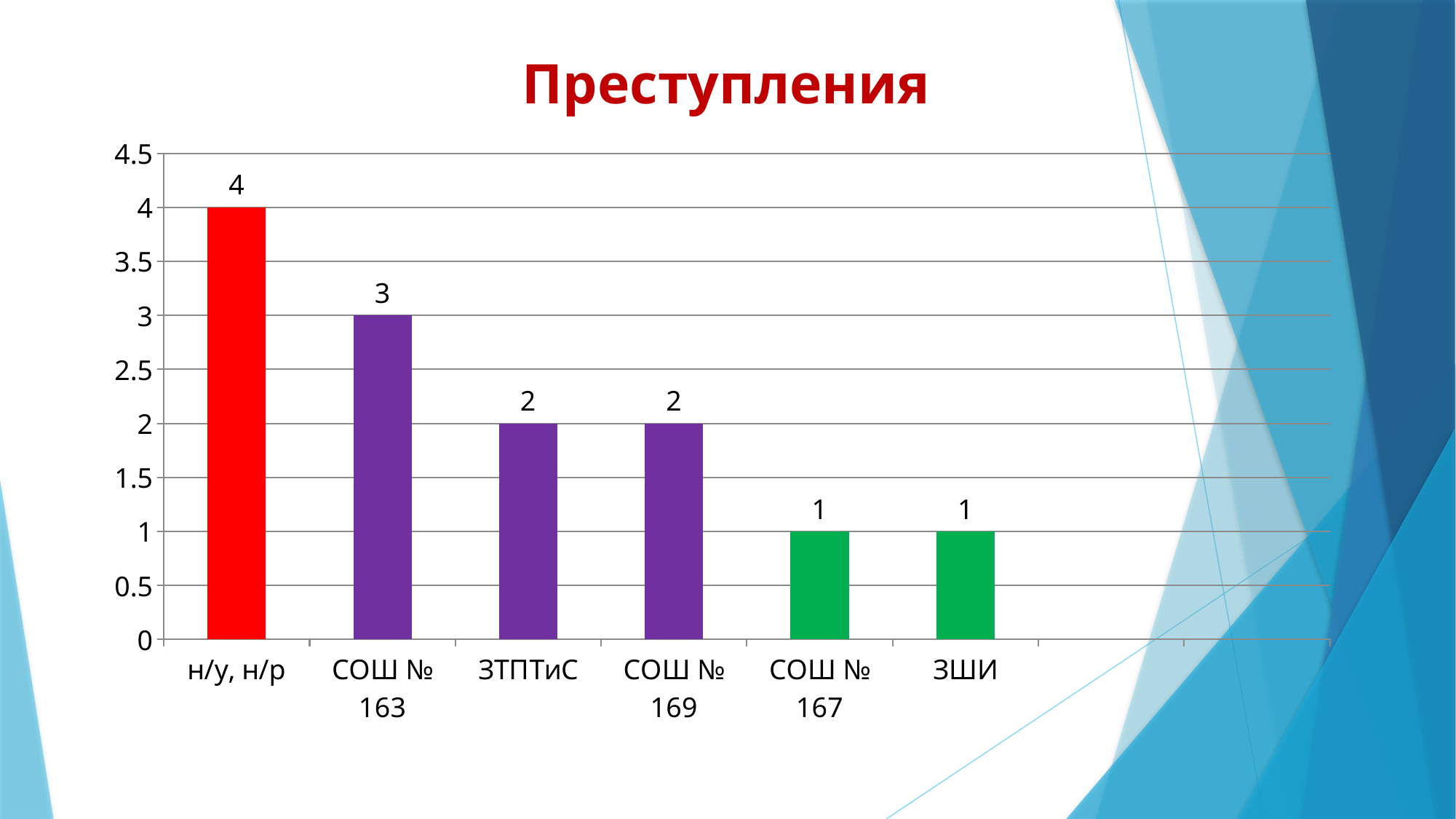
Which is larger, the value for СОШ № 163 or the value for ЗТПТиС? СОШ № 163 What is the value for ЗШИ? 1 What is the title of the chart? Преступления What is the difference between the values for н/у, н/р and СОШ № 163? 1 What is the difference between the values for СОШ № 169 and СОШ № 167? 1 What is the value for ЗТПТиС? 2 What is the value for СОШ № 163? 3 What is the value for н/у, н/р? 4 Which category has the highest value? н/у, н/р Is the value for н/у, н/р greater or less than 3.5? greater How many categories are shown on the x axis? 6 What kind of chart is shown on the slide? bar chart